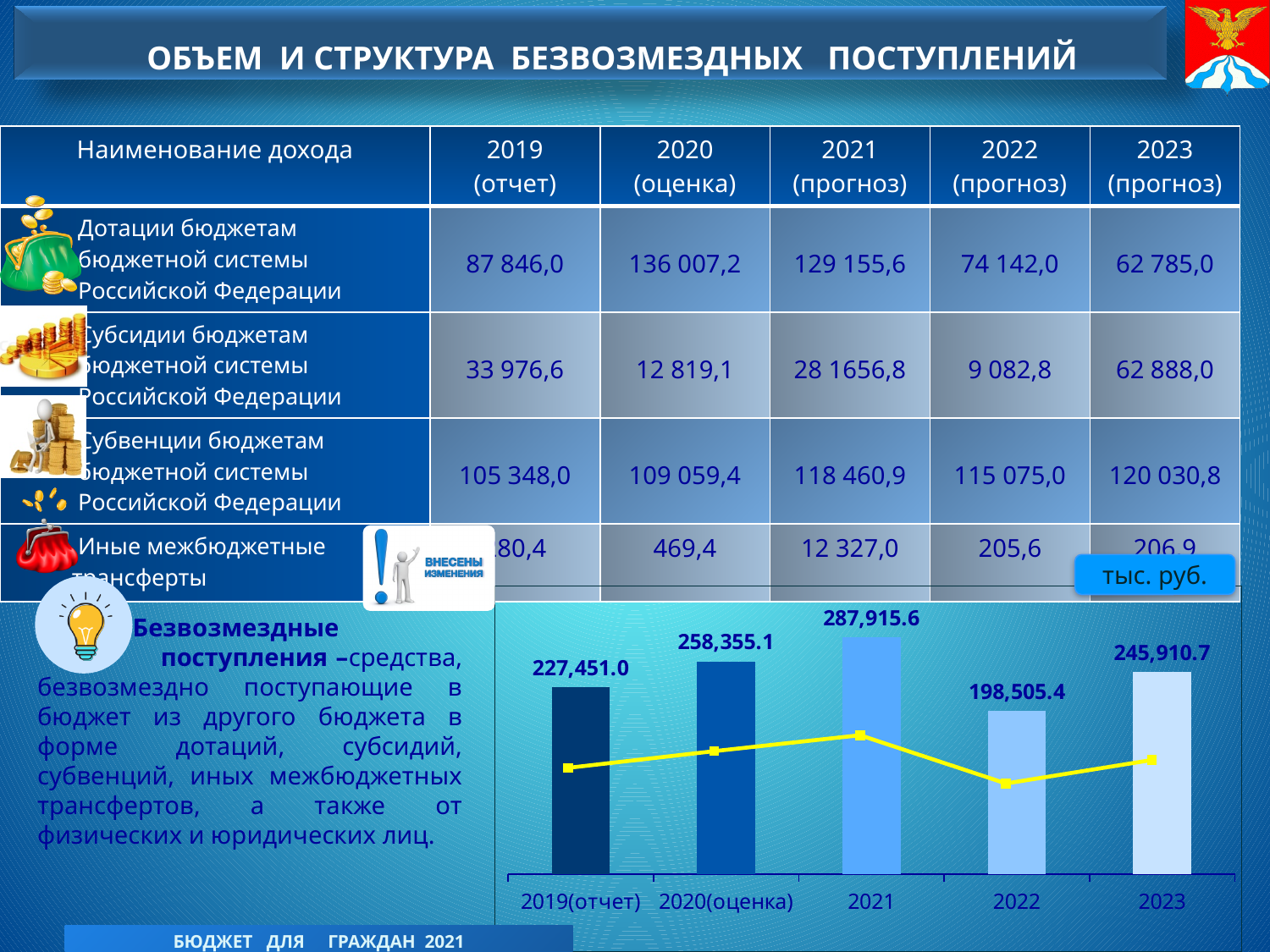
How many years are shown on the x axis of the chart? 5 Which year has the highest value in the chart? 2021 What is the difference between the values for 2021 and 2022 in the chart? 89,410.2 What is the value shown for 2021 in the chart? 287,915.6 What kind of chart is shown at the bottom right of the slide? bar chart with a line What is the difference between the values for 2020(оценка) and 2019(отчет) in the chart? 30,904.1 What is the value shown for 2023 in the chart? 245,910.7 What is the value shown for 2019(отчет) in the chart? 227,451.0 What is the value shown for 2022 in the chart? 198,505.4 Do the bar values rise or fall from 2019(отчет) to 2021 in the chart? rise Which is larger in the chart, the value for 2023 or the value for 2020(оценка)? 2020(оценка) Which year has the lowest value in the chart? 2022